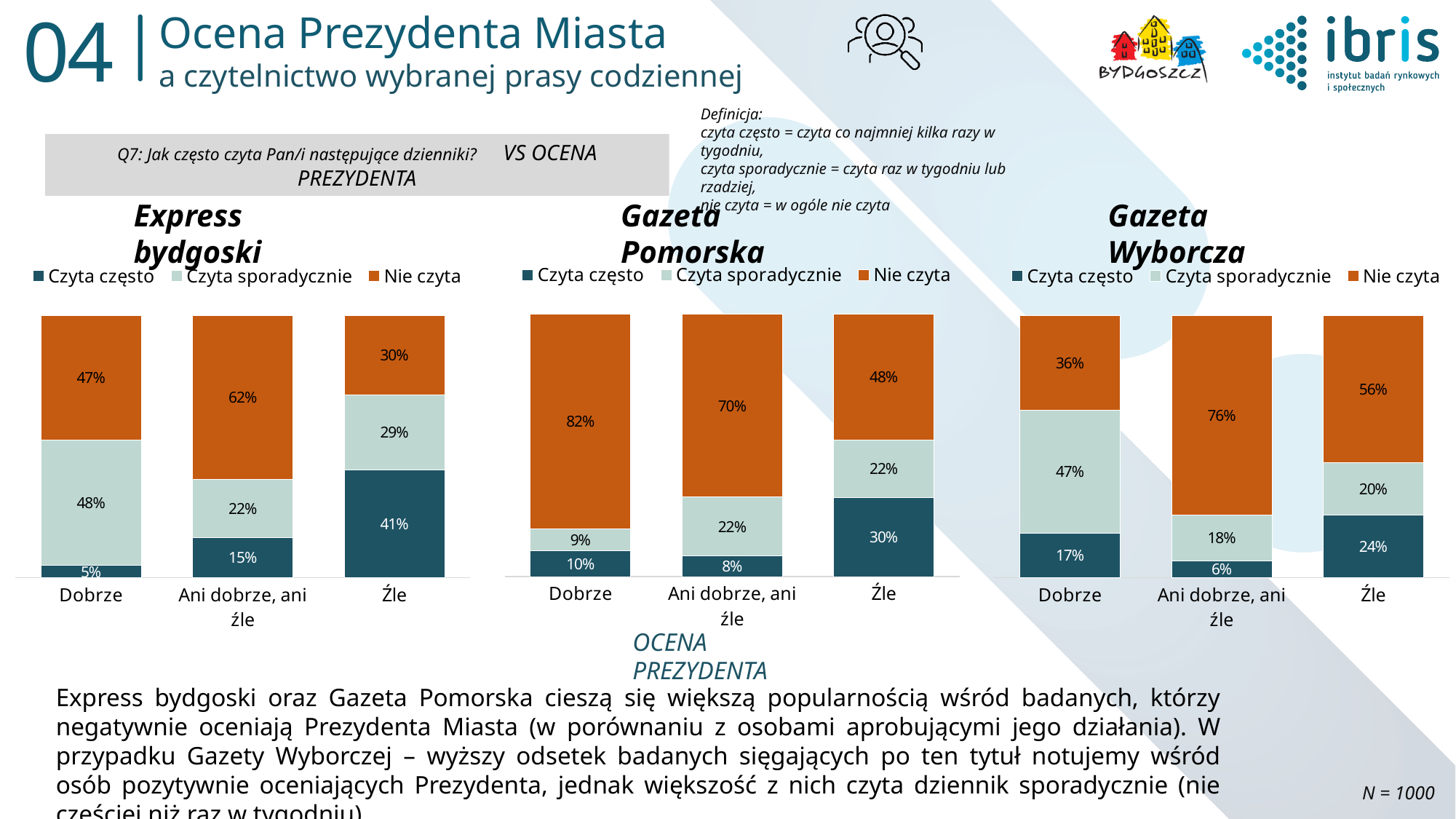
In the Gazeta Wyborcza chart, which category has the highest Nie czyta value? Ani dobrze, ani źle What kind of chart is the Gazeta Wyborcza chart? Stacked bar chart Which series is shown in orange in the three charts? Nie czyta How many categories are shown on the x axis of the Gazeta Pomorska chart? 3 In the Express bydgoski chart, which category has the lowest Czyta często value? Dobrze In the Gazeta Pomorska chart, what is the value of Nie czyta for Dobrze? 82% In the Gazeta Pomorska chart, what is the difference between the Nie czyta values for Dobrze and Źle? 34 percentage points How many series does the legend of the Express bydgoski chart list? 3 In the Gazeta Wyborcza chart, what is the value of Czyta sporadycznie for Dobrze? 47% In the Express bydgoski chart, what is the value of Czyta często for Źle? 41% In the Gazeta Wyborcza chart, which is larger: Czyta często for Dobrze or Czyta często for Źle? Czyta często for Źle In the Gazeta Pomorska chart, does the Czyta często value rise or fall from Ani dobrze, ani źle to Źle? Rise